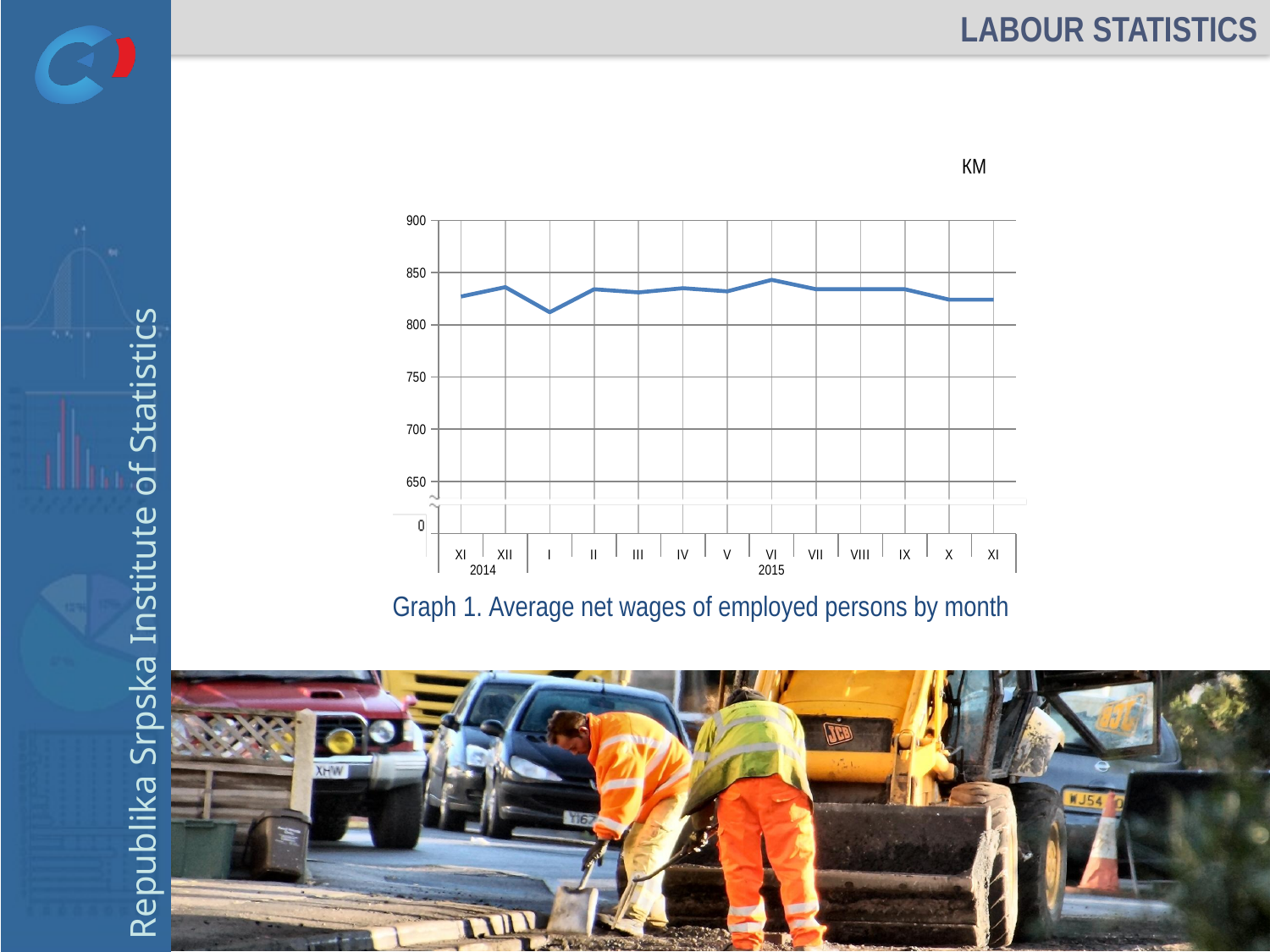
Is the value for XI 2015 greater or less than 750? greater What is the title of the chart on the slide? Graph 1. Average net wages of employed persons by month Is the value for VI 2015 greater or less than 800? greater Which month has the lowest average net wage on the chart? I 2015 Which is larger, the value for XII 2014 or the value for I 2015? XII 2014 What unit is shown above the chart for the plotted values? KM Is the value for I 2015 greater or less than 850? less Which is larger, the value for VI 2015 or the value for X 2015? VI 2015 What kind of chart is Graph 1? line chart How many monthly data points are plotted on the line? 13 Do the values rise or fall from VI 2015 to XI 2015? fall Which month has the highest average net wage on the chart? VI 2015